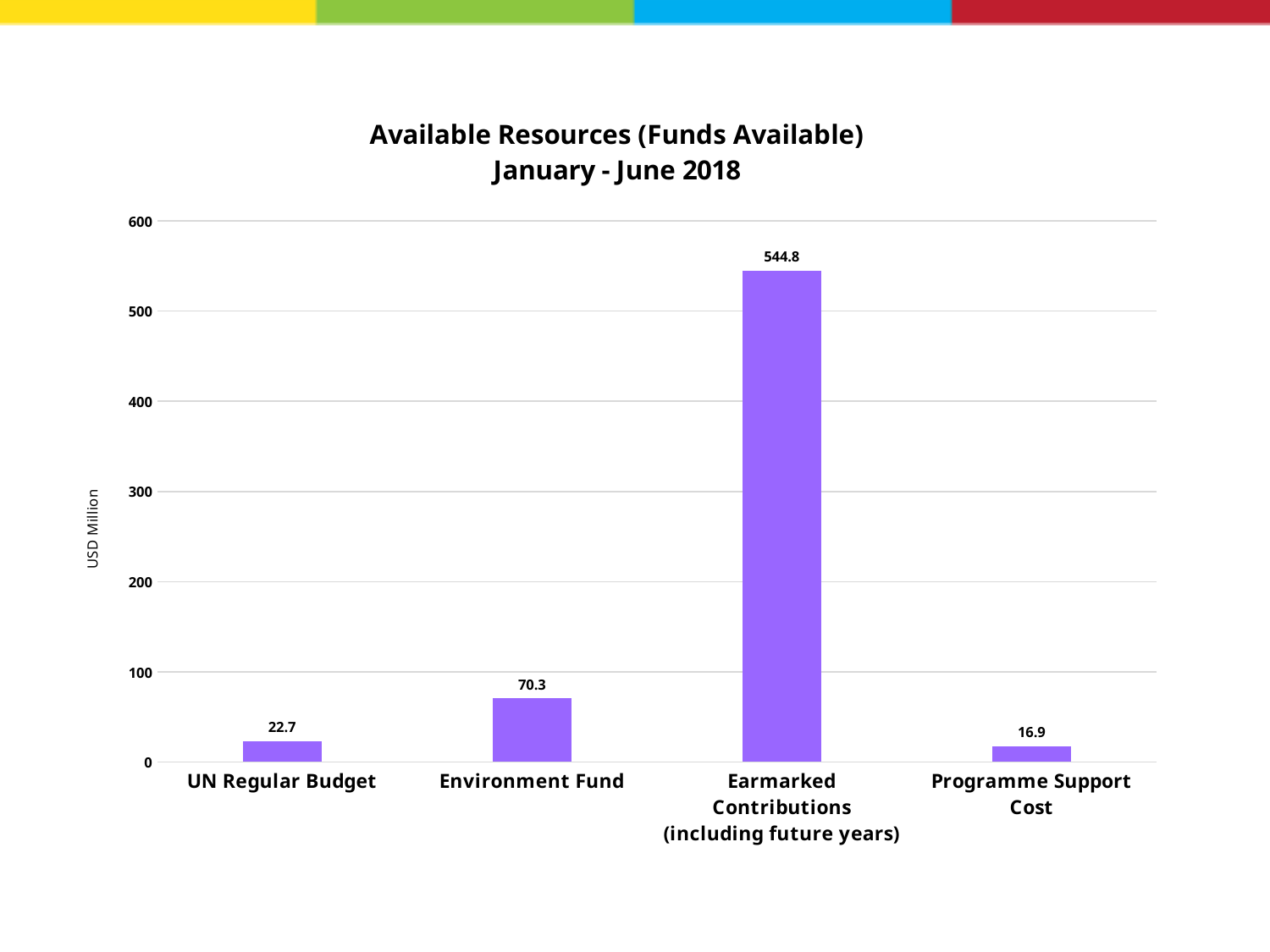
Is the value for Earmarked Contributions (including future years) greater or less than 500? greater What kind of chart is shown on the slide? Bar chart What is the value for Programme Support Cost? 16.9 What is the value for UN Regular Budget? 22.7 Which category has the highest value? Earmarked Contributions (including future years) How many categories are shown on the x axis? 4 What is the value for Environment Fund? 70.3 What is the label of the y axis? USD Million Which category has the lowest value? Programme Support Cost What is the difference between the values for Environment Fund and UN Regular Budget? 47.6 Which is larger, the value for UN Regular Budget or the value for Programme Support Cost? UN Regular Budget What is the value for Earmarked Contributions (including future years)? 544.8